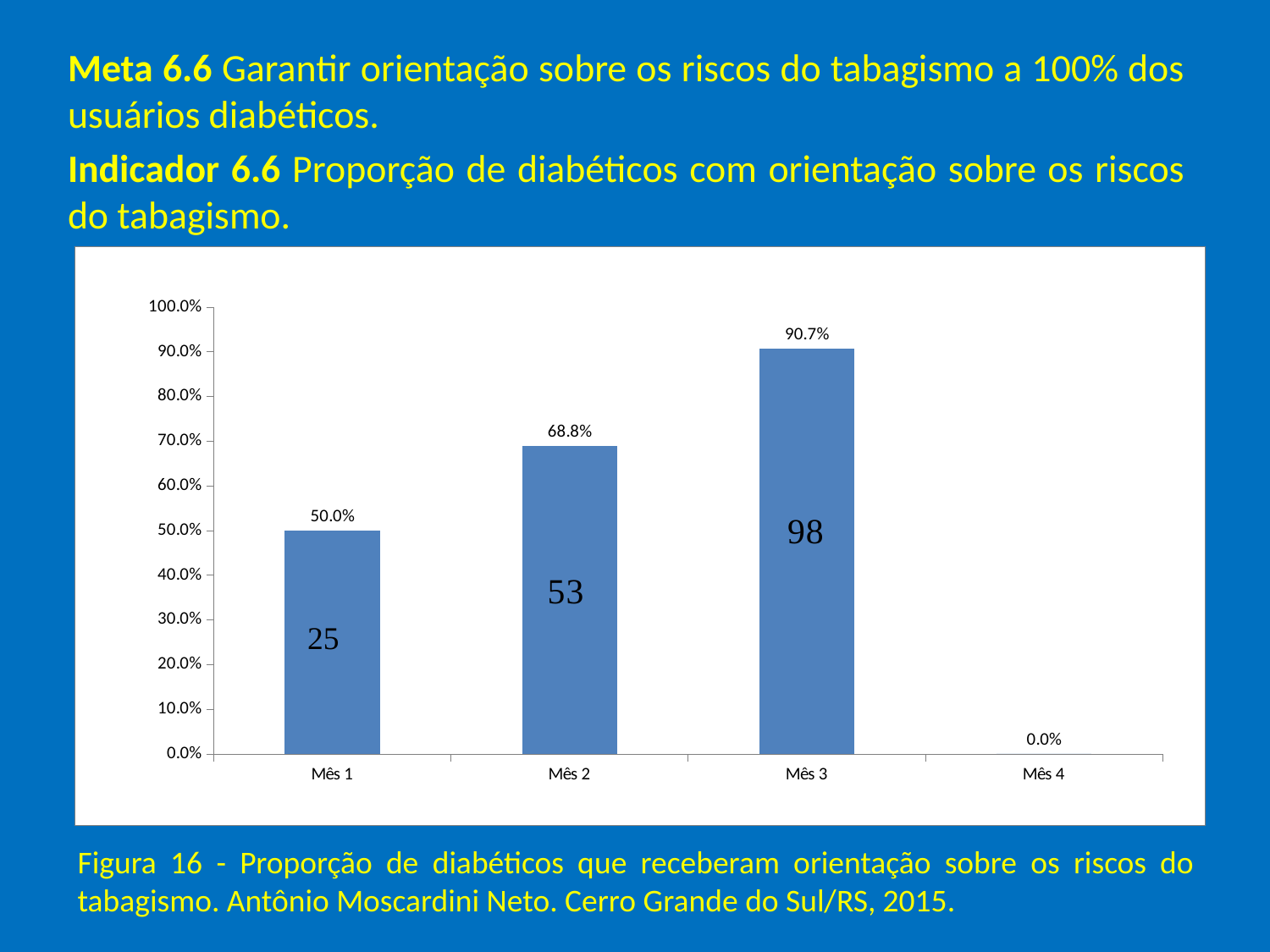
What is the difference between the values for Mês 3 and Mês 2? 21.9% What kind of chart is shown on the slide? Bar chart How many months are shown on the x axis? 4 Which is larger, the value for Mês 1 or the value for Mês 2? Mês 2 Which month has the lowest value? Mês 4 What is the difference between the values for Mês 2 and Mês 1? 18.8% What number is printed inside the bar for Mês 3? 98 What is the value for Mês 3? 90.7% What is the value for Mês 2? 68.8% What is the value for Mês 4? 0.0% Which month has the highest value? Mês 3 What is the value for Mês 1? 50.0%